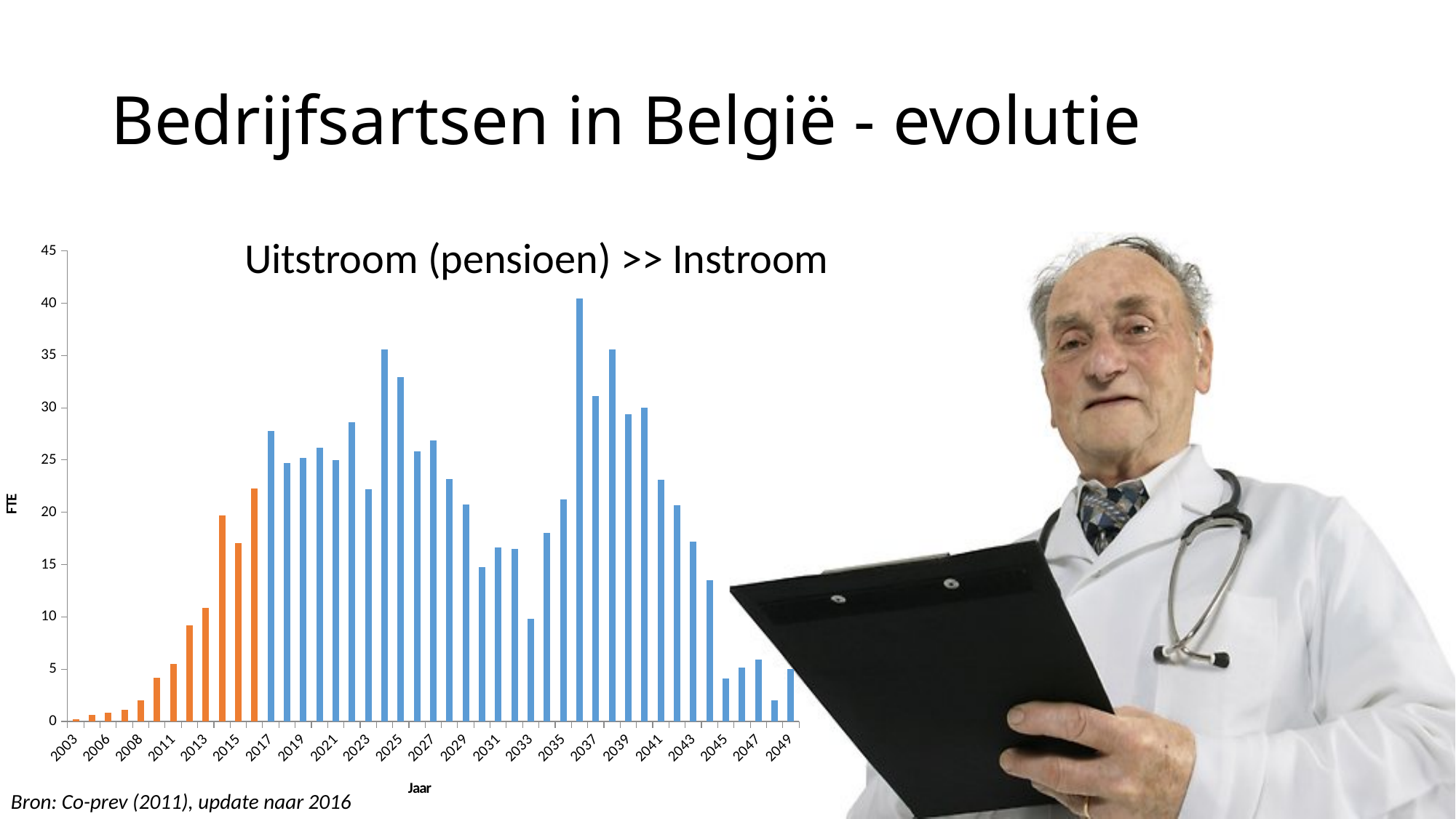
Do the values rise or fall from 2003 to 2016? rise Is the value for 2037 greater or less than 35? less Which year has the larger value, 2025 or 2037? 2025 What label is on the vertical axis of the chart? FTE Which year has the larger value, 2033 or 2035? 2035 Is the value for 2033 greater or less than 15? less Which year has the highest bar in the chart? 2036 What is the title of the chart? Uitstroom (pensioen) >> Instroom Which year has the lowest bar in the chart? 2003 Is the value for 2011 greater or less than 10? less What kind of chart is shown on the slide? bar chart